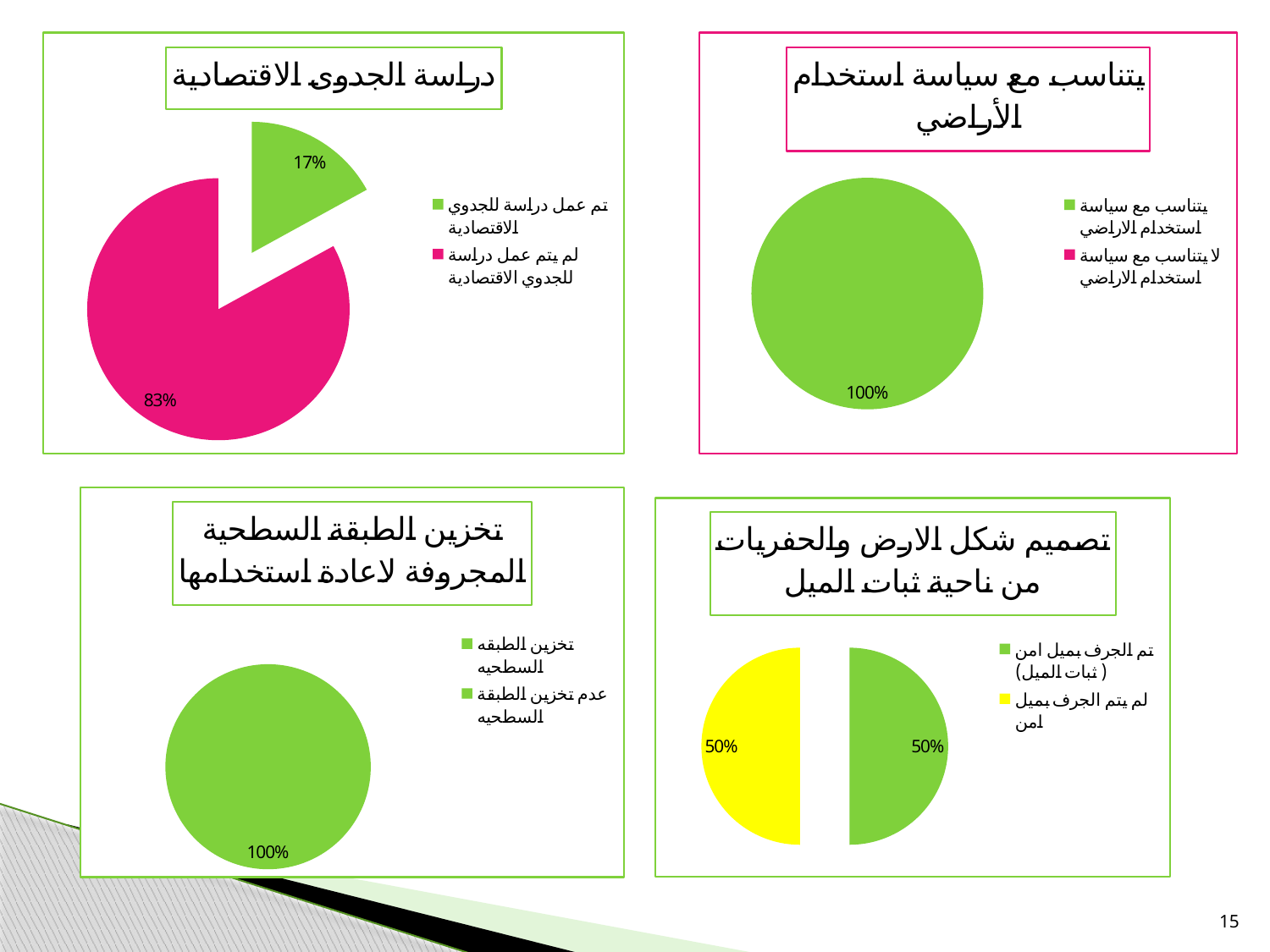
In the bottom-right pie chart titled "تصميم شكل الارض والحفريات من ناحية ثبات الميل", what percentage is shown for "لم يتم الجرف بميل امن"? 50% In the bottom-right pie chart titled "تصميم شكل الارض والحفريات من ناحية ثبات الميل", what colour is the slice for "لم يتم الجرف بميل امن"? Yellow In the top-left pie chart titled "دراسة الجدوى الاقتصادية", what percentage is shown for "لم يتم عمل دراسة للجدوي الاقتصادية"? 83% In the top-left pie chart titled "دراسة الجدوى الاقتصادية", which slice is the largest? لم يتم عمل دراسة للجدوي الاقتصادية In the top-left pie chart titled "دراسة الجدوى الاقتصادية", what is the difference in percentage points between the two slices? 66 How many entries does the legend of the top-right pie chart titled "يتناسب مع سياسة استخدام الأراضي" list? 2 In the top-left pie chart titled "دراسة الجدوى الاقتصادية", what percentage is shown for "تم عمل دراسة للجدوى الاقتصادية"? 17% What type of chart is used in the bottom-left chart titled "تخزين الطبقة السطحية المجروفة لاعادة استخدامها"? Pie chart In the top-right pie chart titled "يتناسب مع سياسة استخدام الأراضي", what percentage is shown for "يتناسب مع سياسة استخدام الاراضي"? 100% How many pie charts are shown on the slide? 4 In the top-left pie chart titled "دراسة الجدوى الاقتصادية", which is larger: the slice for "تم عمل دراسة للجدوى الاقتصادية" or the slice for "لم يتم عمل دراسة للجدوي الاقتصادية"? لم يتم عمل دراسة للجدوي الاقتصادية